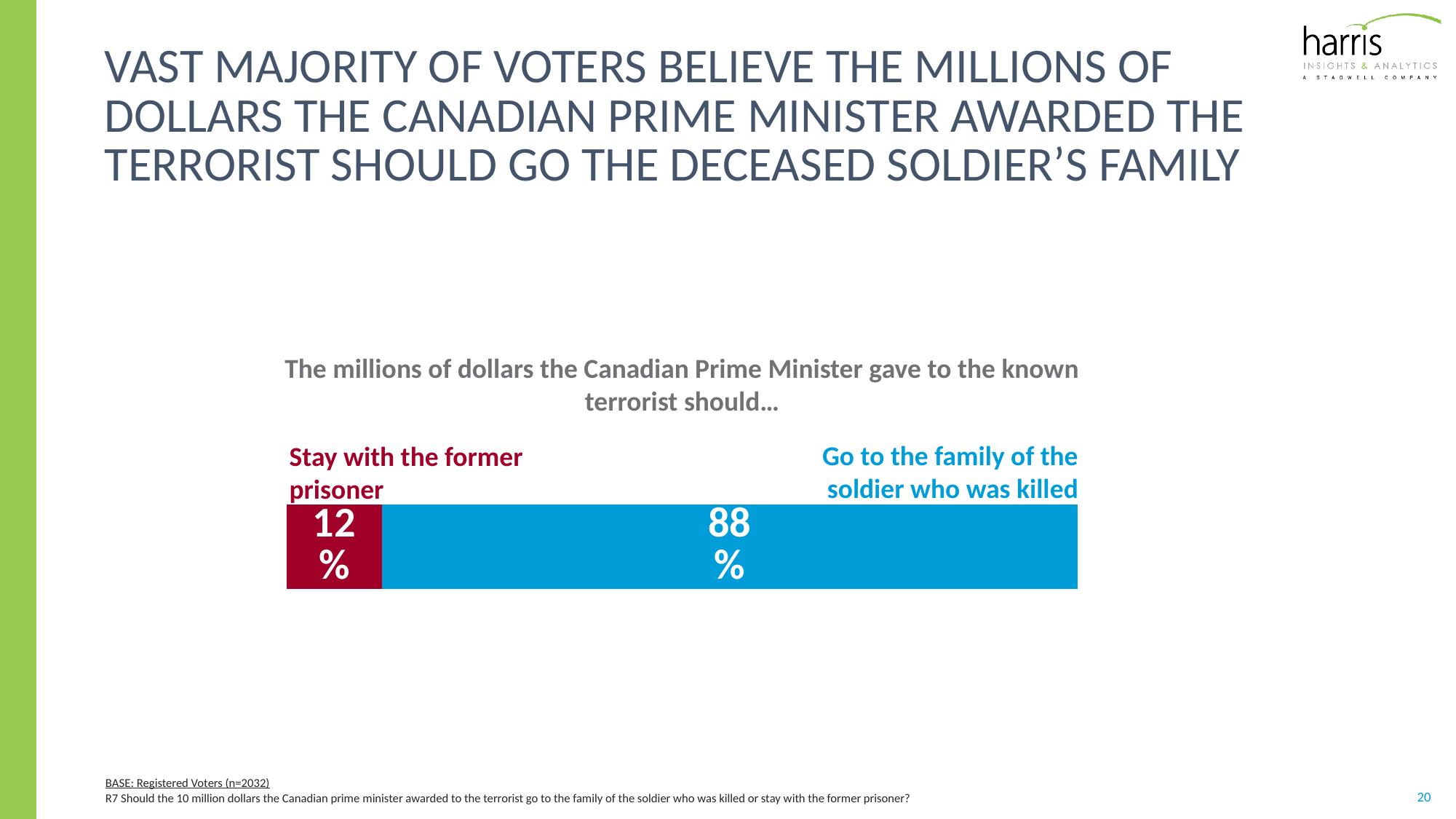
What kind of chart is shown on the slide? Stacked bar chart What percentage of voters say the money should go to the family of the soldier who was killed? 88% Which response received the larger share: 'Stay with the former prisoner' or 'Go to the family of the soldier who was killed'? Go to the family of the soldier who was killed Which response has the highest percentage? Go to the family of the soldier who was killed How many response categories are shown in the chart? 2 What is the difference in percentage points between 'Go to the family of the soldier who was killed' and 'Stay with the former prisoner'? 76 What colour is the segment for 'Stay with the former prisoner'? Red What is the title of the chart? The millions of dollars the Canadian Prime Minister gave to the known terrorist should… Which response has the lowest percentage? Stay with the former prisoner What is the total of the two segments in the stacked bar? 100% What percentage of voters say the money should stay with the former prisoner? 12%